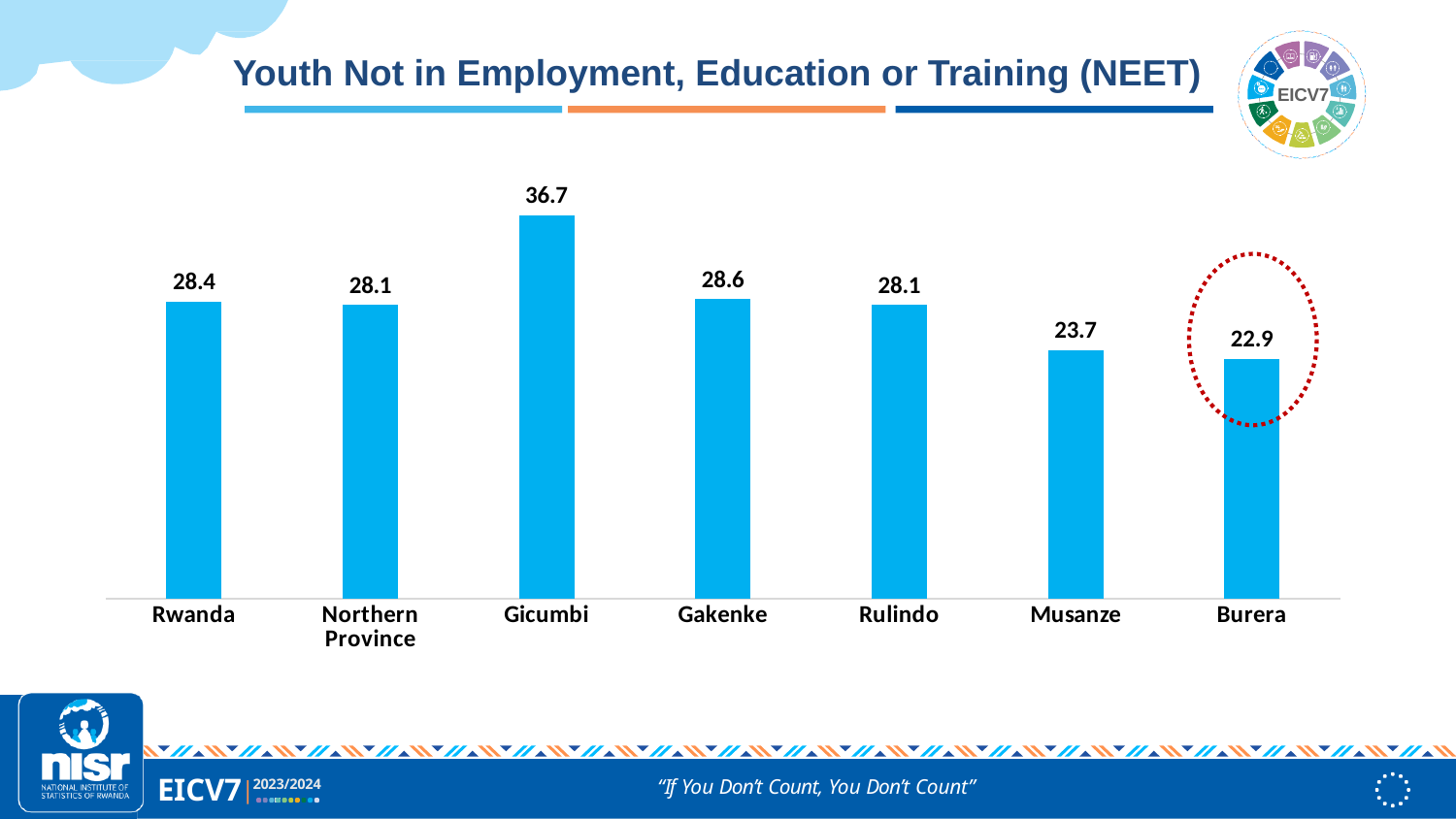
What is the NEET value for Rwanda? 28.4 What is the difference between the NEET values for Gicumbi and Burera? 13.8 What kind of chart is shown on the slide? Bar chart What is the NEET value for Musanze? 23.7 What is the difference between the NEET values for Rwanda and Northern Province? 0.3 What is the NEET value for Gicumbi? 36.7 What is the NEET value for Burera? 22.9 Which has a larger NEET value, Gakenke or Musanze? Gakenke How many categories are shown on the x axis? 7 Which category has the lowest NEET value? Burera Which category has the highest NEET value? Gicumbi What is the title of the chart? Youth Not in Employment, Education or Training (NEET)